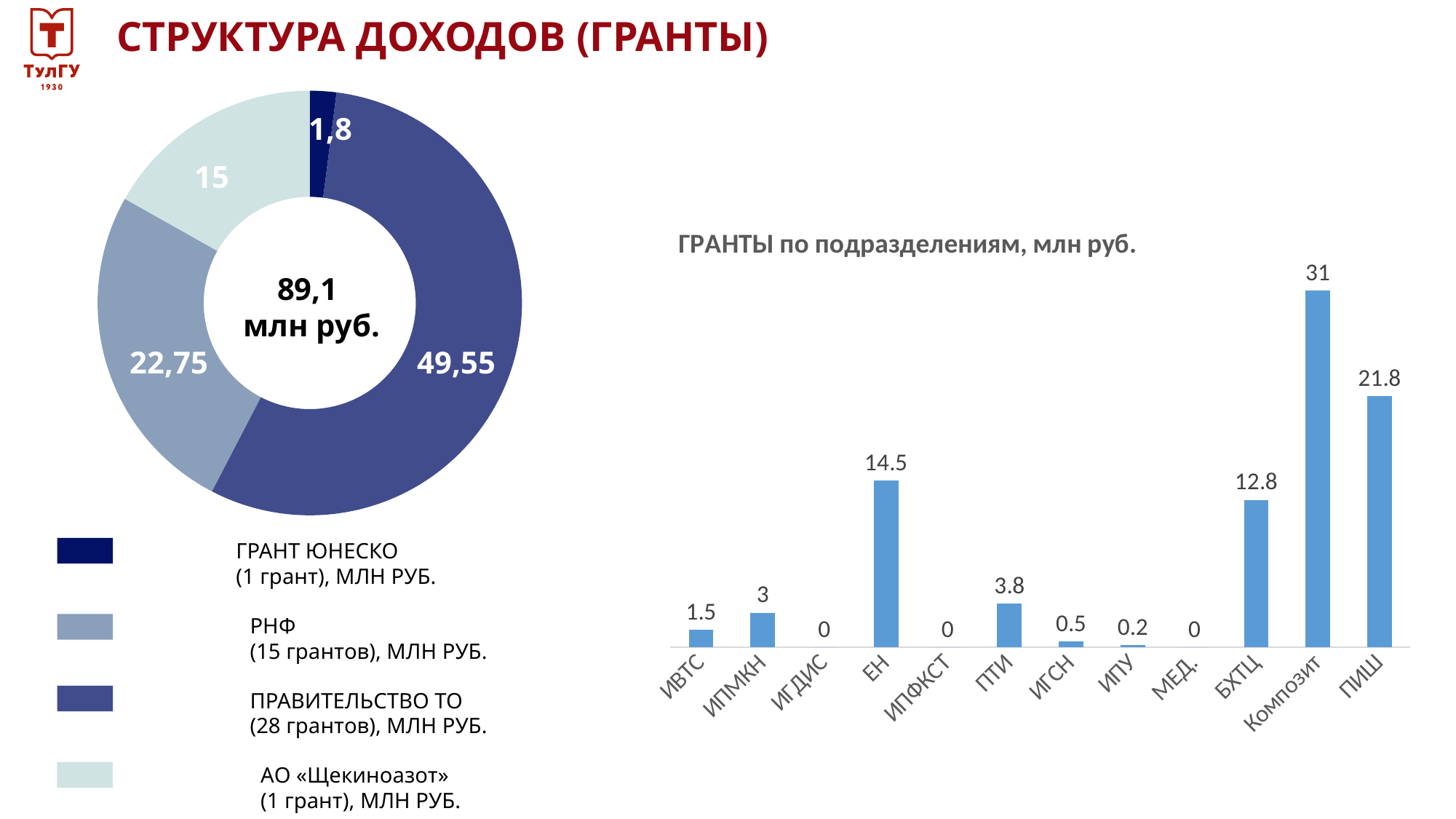
What total is shown in the centre of the donut chart on the left? 89,1 млн руб. In the donut chart on the left, what is the value for РНФ? 22,75 In the bar chart 'ГРАНТЫ по подразделениям, млн руб.', how many divisions have a value of 0? 3 In the bar chart 'ГРАНТЫ по подразделениям, млн руб.', what is the difference between Композит and ПИШ? 9.2 In the bar chart 'ГРАНТЫ по подразделениям, млн руб.', what is the value for Композит? 31 In the bar chart 'ГРАНТЫ по подразделениям, млн руб.', which division has the highest value? Композит What type of chart is the chart on the right of the slide? bar chart How many divisions are shown in the bar chart 'ГРАНТЫ по подразделениям, млн руб.'? 12 In the donut chart on the left, what is the value for ПРАВИТЕЛЬСТВО ТО? 49,55 In the bar chart 'ГРАНТЫ по подразделениям, млн руб.', which is larger, БХТЦ or ЕН? ЕН In the donut chart on the left, which source has the smallest value? ГРАНТ ЮНЕСКО In the bar chart 'ГРАНТЫ по подразделениям, млн руб.', what is the value for ЕН? 14.5